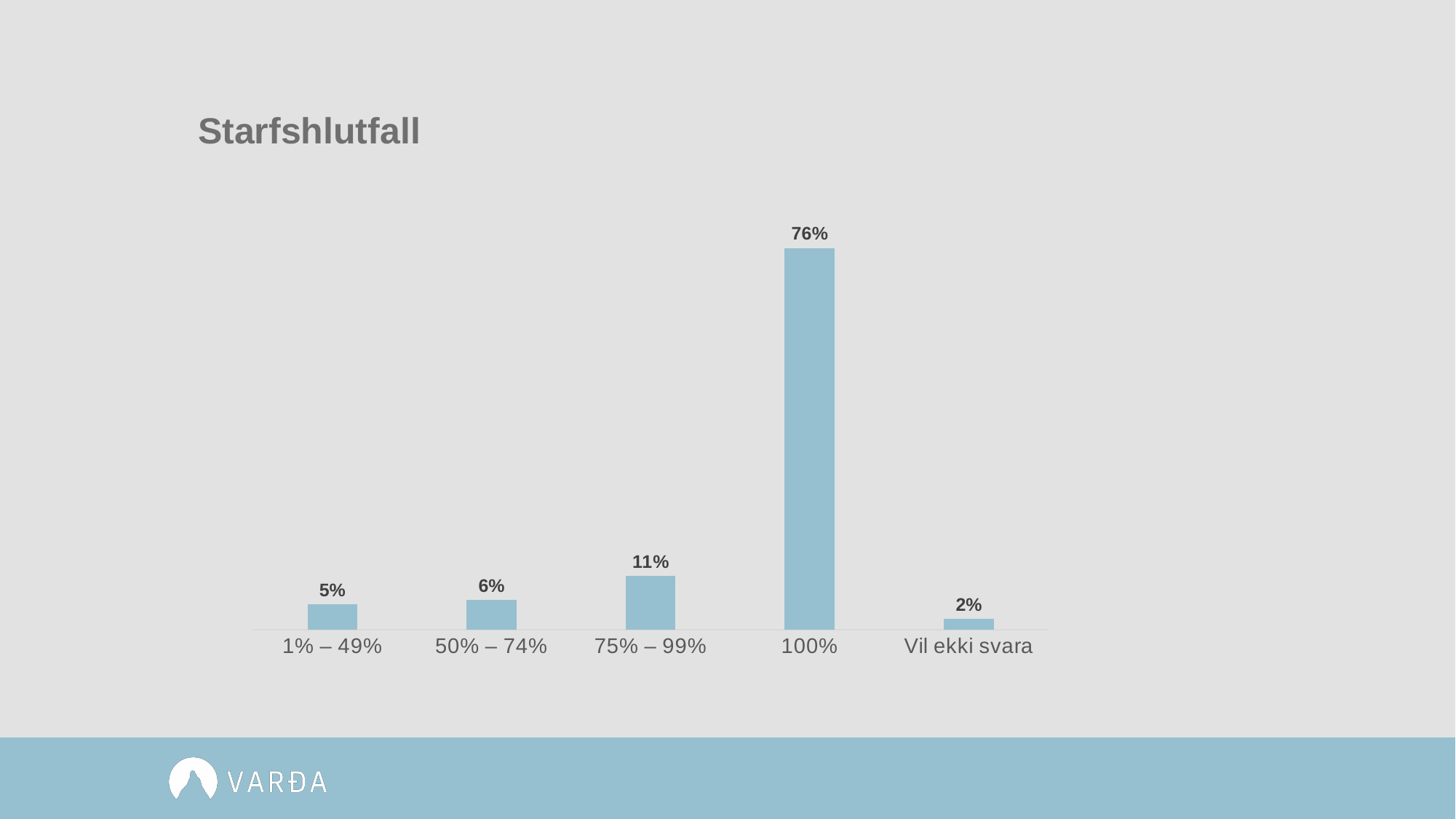
Which category has the highest value? 100% What is the value for the 75% – 99% category? 11% What is the title of the chart? Starfshlutfall What is the difference between the values for 100% and 75% – 99%? 65% How many categories are shown on the x axis? 5 What is the value for the 1% – 49% category? 5% What is the value for Vil ekki svara? 2% What is the value for the 100% category? 76% Which category has the lowest value? Vil ekki svara Which is larger, the value for 75% – 99% or the value for 50% – 74%? 75% – 99% What is the difference between the values for 50% – 74% and 1% – 49%? 1% What kind of chart is shown on the slide? Bar chart